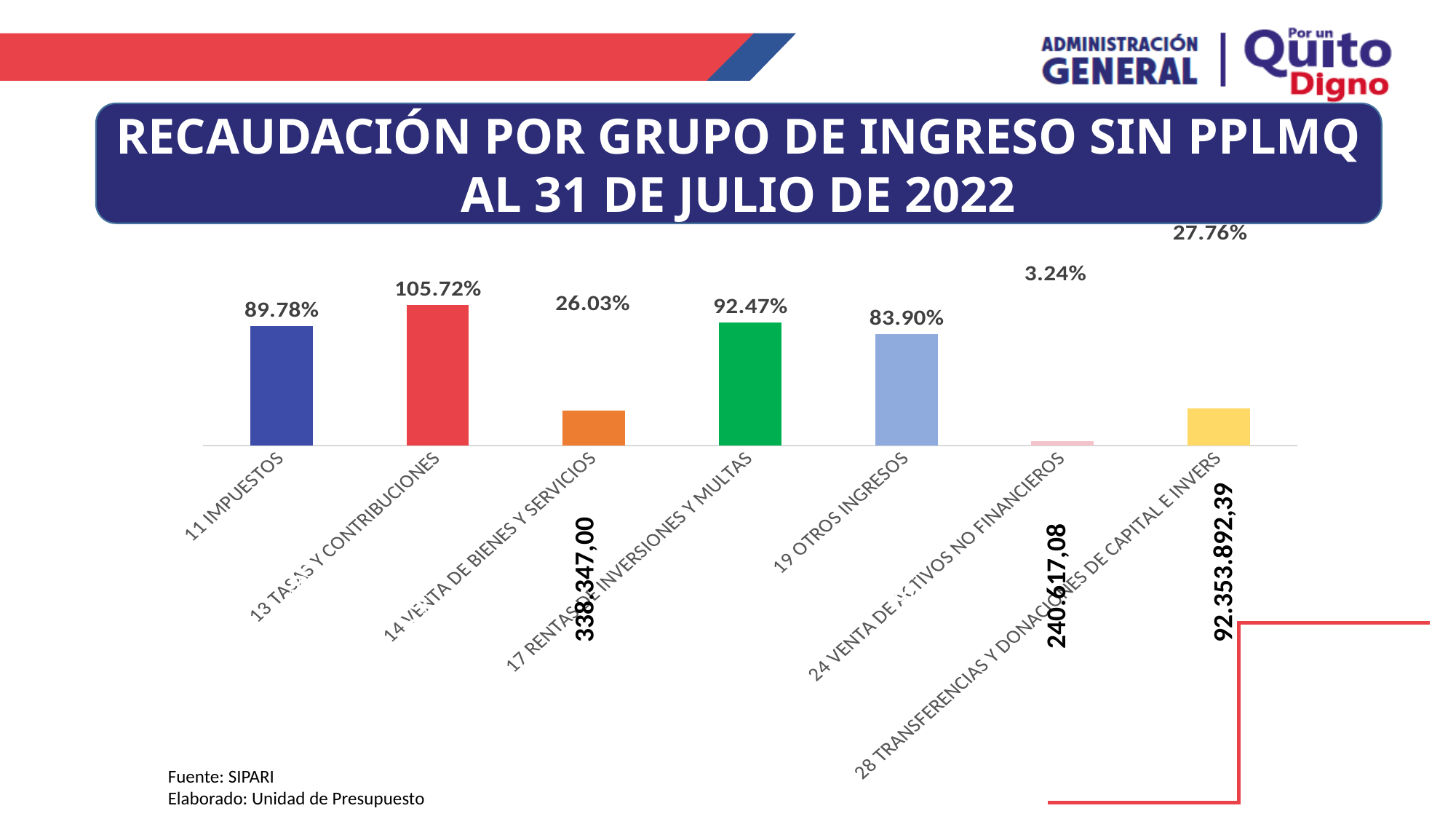
What colour is the bar for 17 RENTAS DE INVERSIONES Y MULTAS? Green Which category has the highest value? 13 TASAS Y CONTRIBUCIONES What is the difference between the values for 13 TASAS Y CONTRIBUCIONES and 11 IMPUESTOS? 15.94% What is the value shown for 11 IMPUESTOS? 89.78% Which is larger, the value for 17 RENTAS DE INVERSIONES Y MULTAS or the value for 19 OTROS INGRESOS? 17 RENTAS DE INVERSIONES Y MULTAS What is the value shown for 14 VENTA DE BIENES Y SERVICIOS? 26.03% What is the value shown for 13 TASAS Y CONTRIBUCIONES? 105.72% What is the value shown for 24 VENTA DE ACTIVOS NO FINANCIEROS? 3.24% What kind of chart is shown on the slide? Bar chart What is the value shown for 19 OTROS INGRESOS? 83.90% How many categories are shown in the chart? 7 Which category has the lowest value? 24 VENTA DE ACTIVOS NO FINANCIEROS